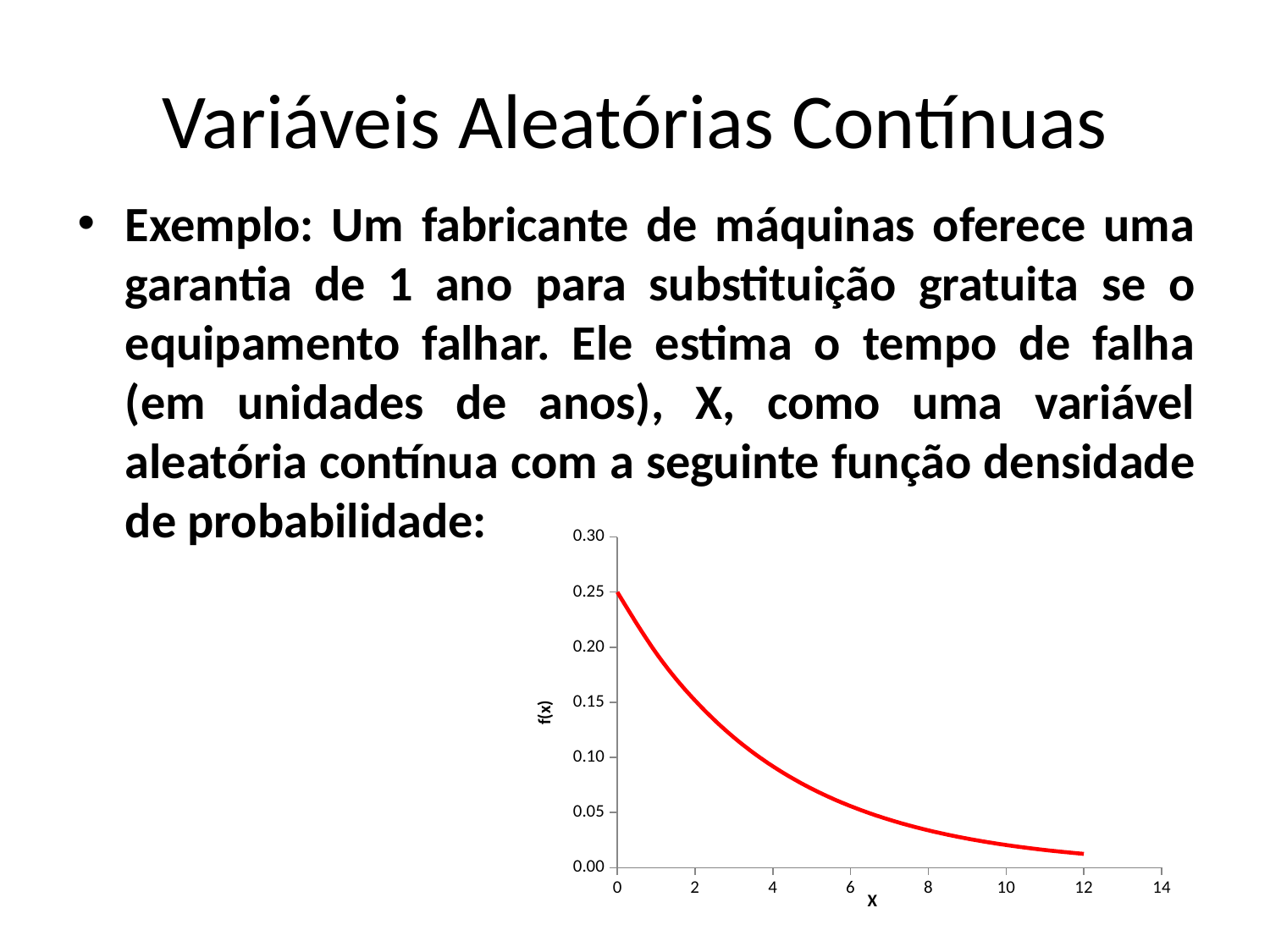
Is the value of f(x) at x = 1 greater or less than 0.15? greater Which is larger, f(x) at x = 2 or f(x) at x = 8? x = 2 What kind of chart is shown on the slide? line chart What is the label of the vertical axis? f(x) Is the value of f(x) at x = 8 greater or less than 0.05? less Does f(x) rise or fall as x increases along the x axis? fall What colour is the plotted curve? red At which value of x is f(x) highest? 0 Is the value of f(x) at x = 4 greater or less than 0.10? less What is the value of f(x) at x = 0? 0.25